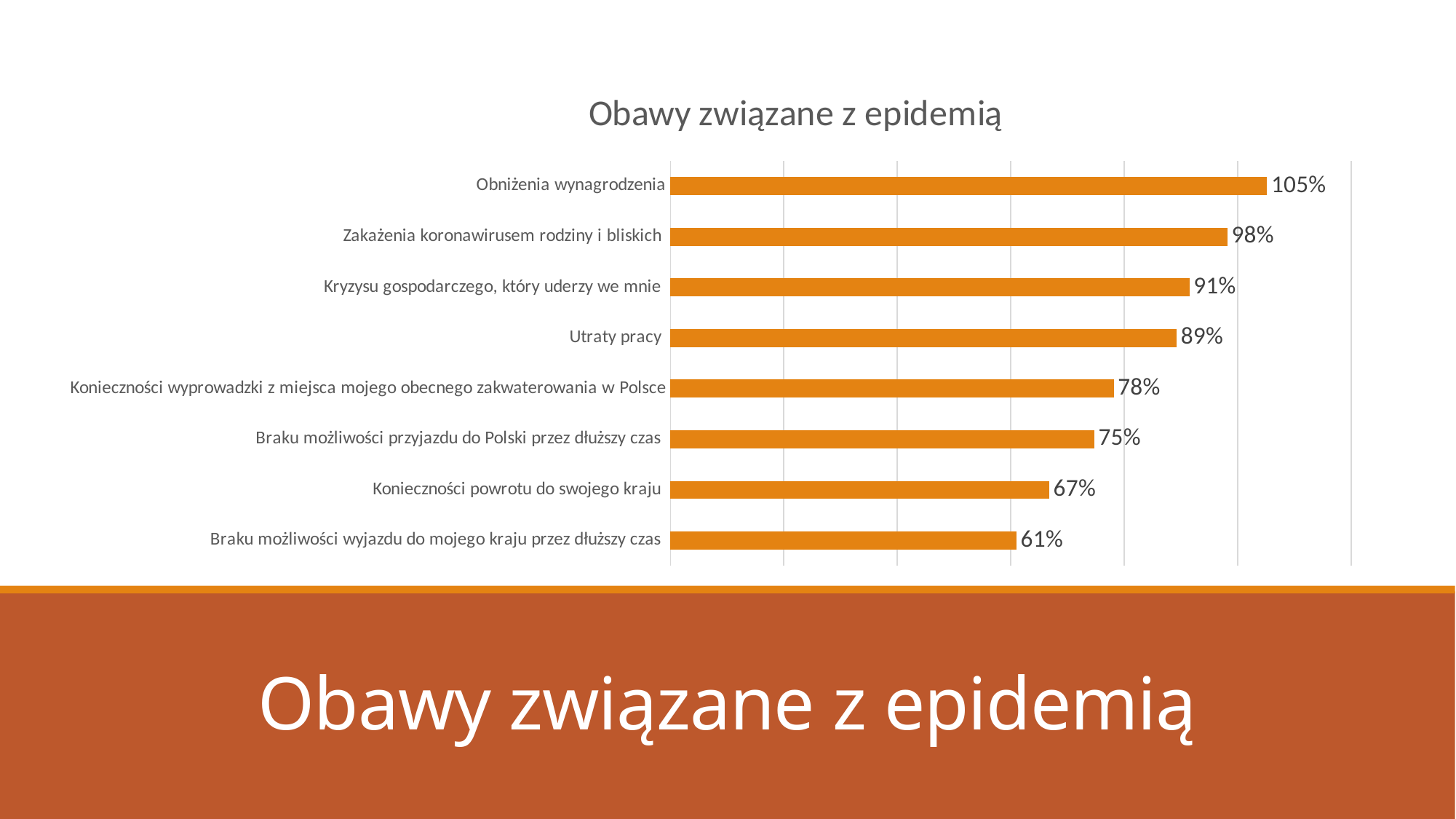
What is the value for "Obniżenia wynagrodzenia"? 105% Which category has the highest value? Obniżenia wynagrodzenia Which category has the lowest value? Braku możliwości wyjazdu do mojego kraju przez dłuższy czas What is the difference between the values for "Obniżenia wynagrodzenia" and "Braku możliwości wyjazdu do mojego kraju przez dłuższy czas"? 44% What is the title of the chart? Obawy związane z epidemią What is the difference between the values for "Zakażenia koronawirusem rodziny i bliskich" and "Kryzysu gospodarczego, który uderzy we mnie"? 7% What is the value for "Konieczności powrotu do swojego kraju"? 67% Which is larger: the value for "Konieczności wyprowadzki z miejsca mojego obecnego zakwaterowania w Polsce" or for "Konieczności powrotu do swojego kraju"? Konieczności wyprowadzki z miejsca mojego obecnego zakwaterowania w Polsce How many categories are shown in the chart? 8 What kind of chart is shown on the slide? Bar chart What is the value for "Utraty pracy"? 89% What is the value for "Braku możliwości przyjazdu do Polski przez dłuższy czas"? 75%